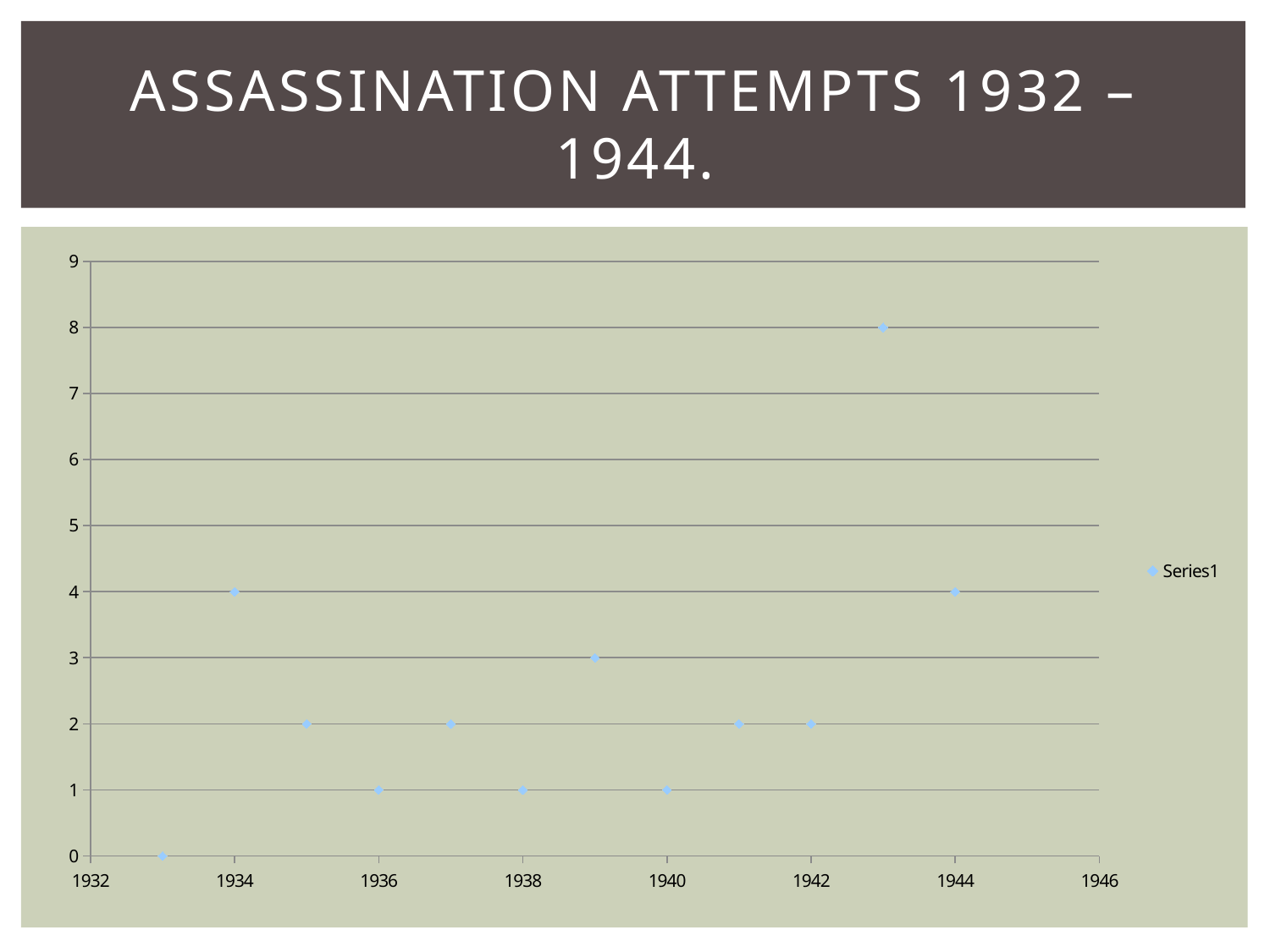
What is the highest value plotted on the chart? 8 Which year has the larger value, 1934 or 1940? 1934 What is the value plotted for 1934? 4 What is the title of the slide containing the chart? Assassination Attempts 1932 – 1944. What is the value plotted for 1942? 2 What is the value plotted for 1936? 1 What type of chart is shown on the slide? Scatter chart What is the lowest value plotted on the chart? 0 How many data points are plotted on the chart? 12 What is the value plotted for 1944? 4 How many series does the legend list? 1 What is the difference between the values for 1944 and 1942? 2